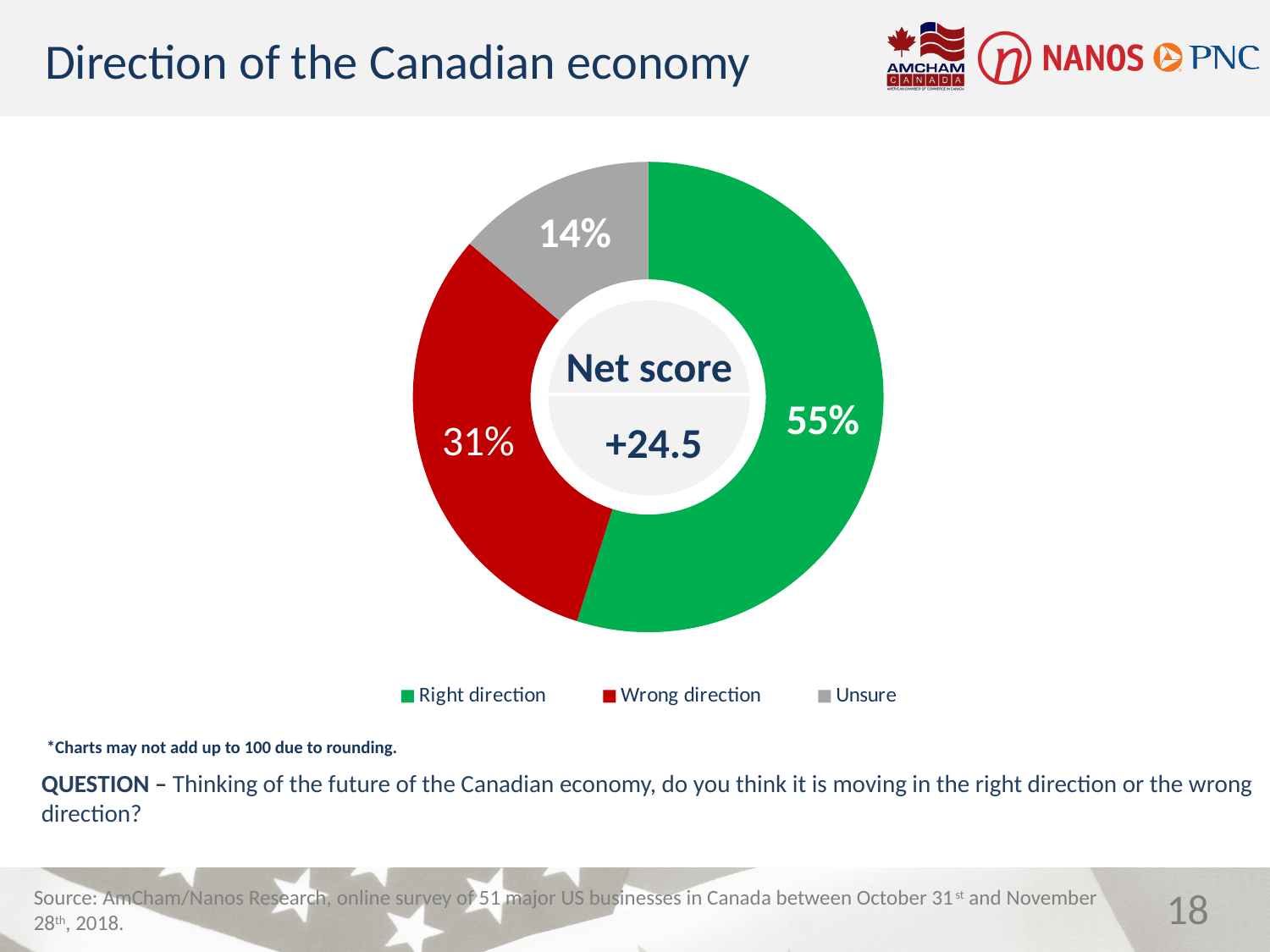
What percentage of respondents said the Canadian economy is moving in the right direction? 55% What net score is shown in the centre of the chart? +24.5 What percentage of respondents were unsure? 14% Which is larger, the share for Wrong direction or the share for Unsure? Wrong direction How many categories are shown in the chart? 3 Which response category has the largest share of the chart? Right direction What kind of chart is shown on the slide? Pie chart (doughnut) What is the combined share of Right direction and Wrong direction? 86% What percentage of respondents said the Canadian economy is moving in the wrong direction? 31% What colour represents the Unsure category in the chart? Grey What is the difference in percentage points between Right direction and Wrong direction? 24 Which response category has the smallest share of the chart? Unsure